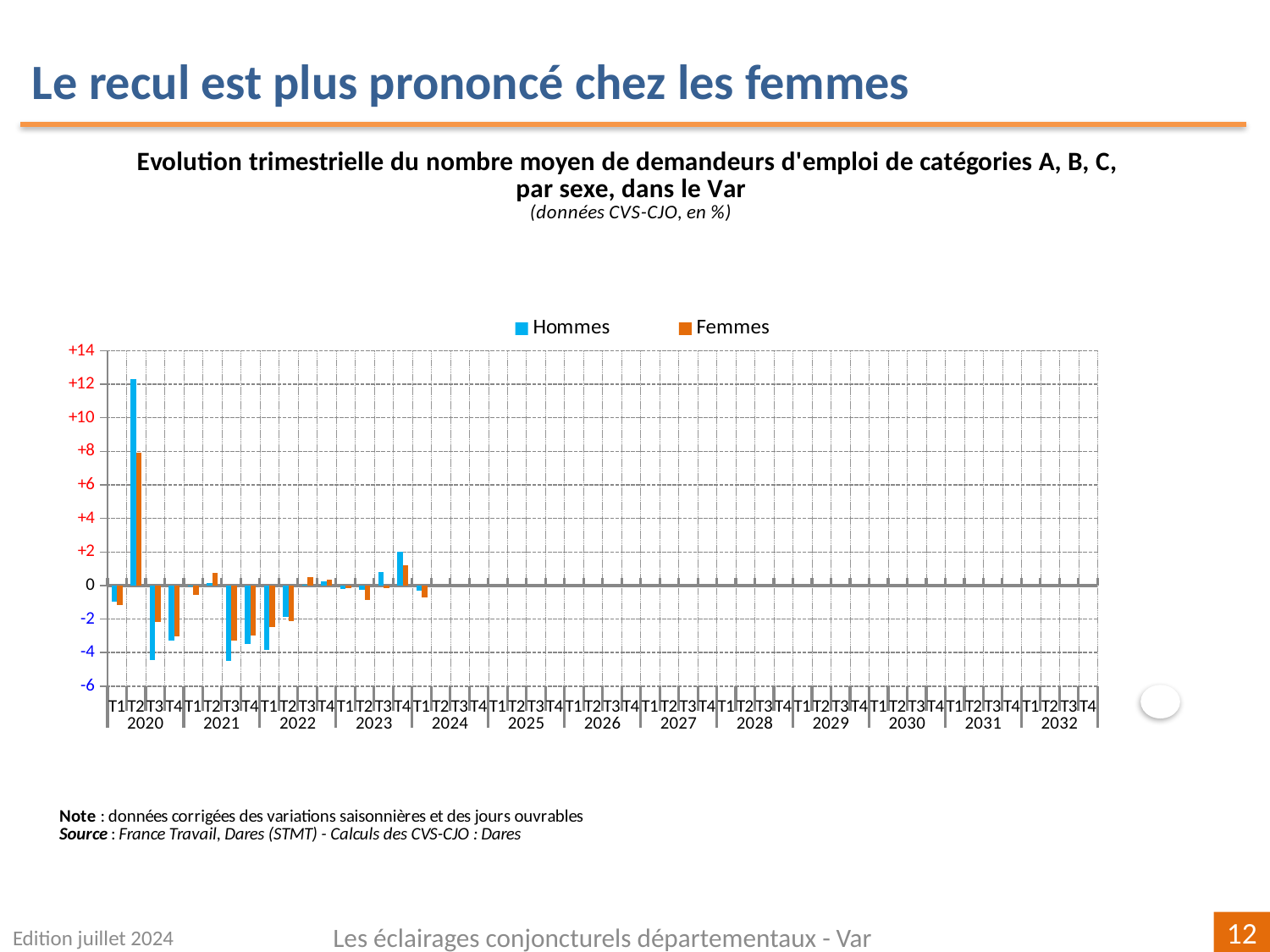
Which series and quarter has the highest value in the chart? Hommes, T2 2020 Is the Femmes value for T2 2020 greater or less than +6? greater Is the Hommes value for T2 2020 greater or less than +10? greater How many series does the legend list? 2 What kind of chart is shown on the slide? bar chart Is the Hommes value for T4 2023 greater or less than +1? greater In T3 2020, which series has the lower (more negative) value, Hommes or Femmes? Hommes What is the highest value shown on the vertical axis of the chart? +14 Which colour represents the Femmes series in the chart? orange In T2 2020, which series has the larger value, Hommes or Femmes? Hommes